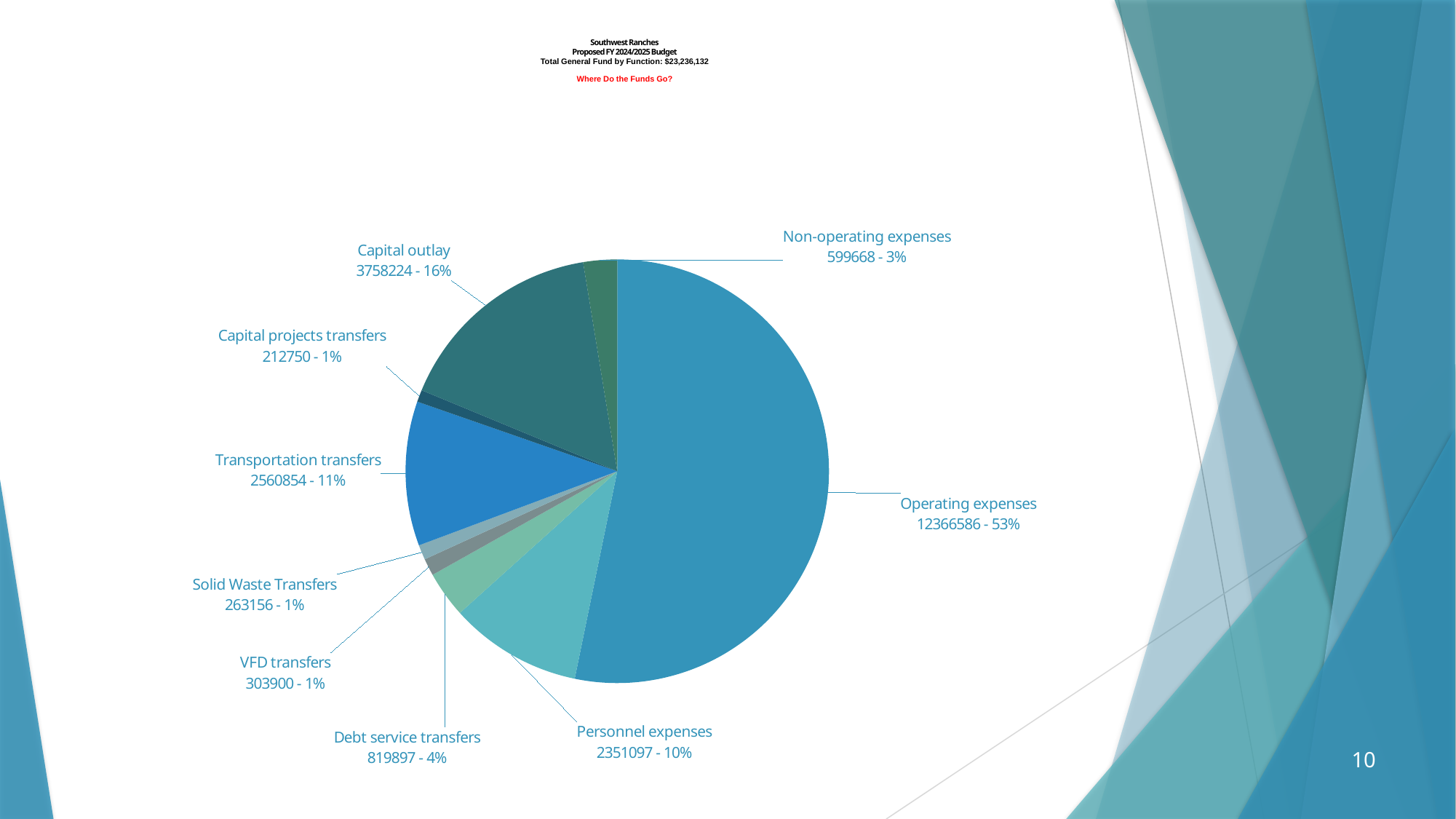
What is the value shown for Capital outlay? 3758224 What kind of chart is shown on the slide? Pie chart Which category has the largest slice of the pie chart? Operating expenses What total General Fund amount is stated in the chart title? $23,236,132 What share of the pie does Operating expenses represent? 53% What is the value shown for Transportation transfers? 2560854 Which category has the smallest value in the pie chart? Capital projects transfers What is the difference between the values for Capital outlay and Transportation transfers? 1197370 What share of the pie does Personnel expenses represent? 10% What is the difference between the values for Debt service transfers and VFD transfers? 515997 Which is larger, the value for Solid Waste Transfers or the value for VFD transfers? VFD transfers How many categories (slices) does the pie chart have? 9